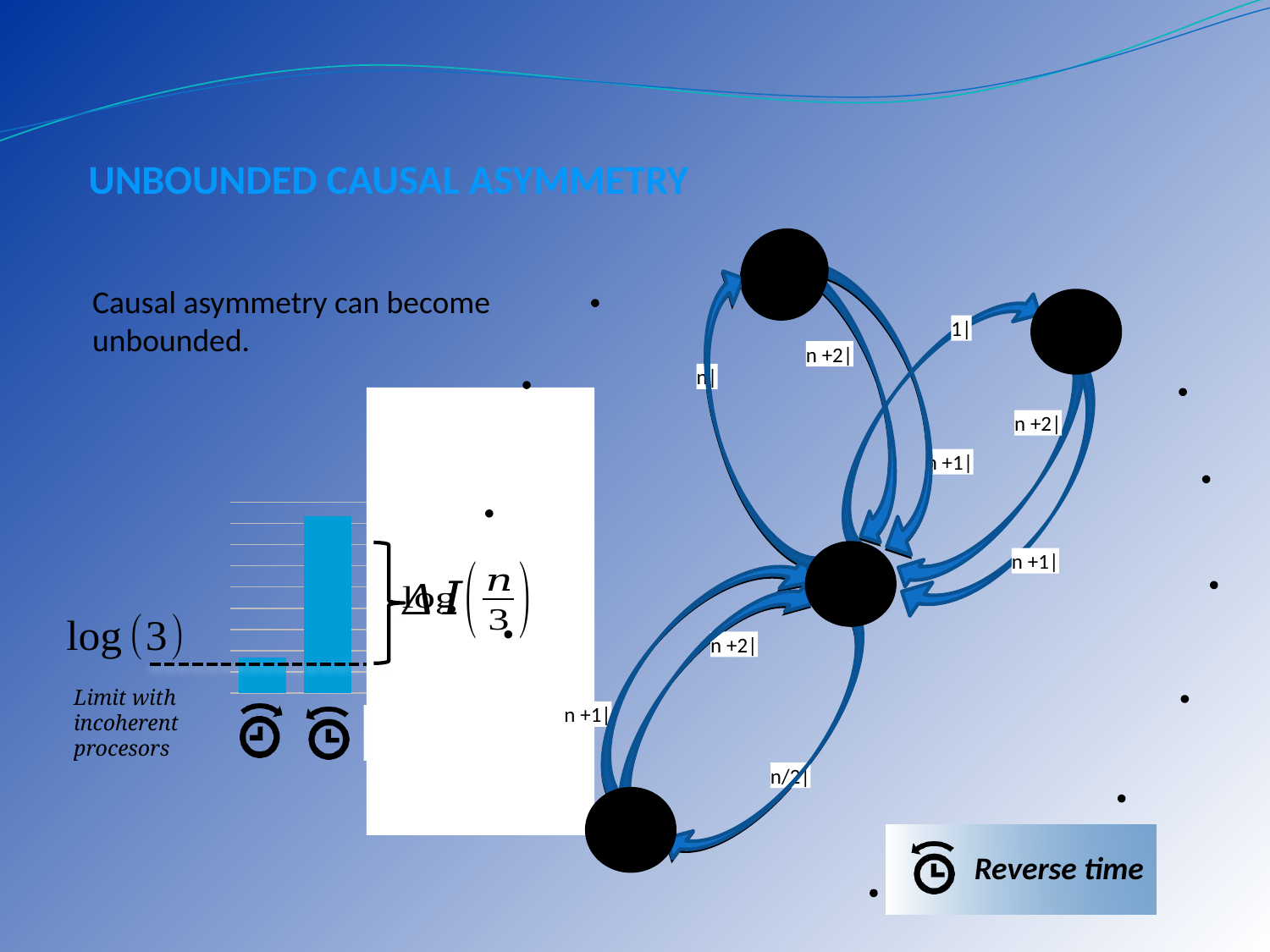
In the bar chart on the left of the slide, which bar is the shortest, the left bar or the right bar? the left bar How many bars does the bar chart on the left of the slide show? 2 What kind of chart is shown on the left of the slide? bar chart In the bar chart on the left of the slide, which bar is taller, the left bar or the right bar? the right bar What label is written next to the dashed horizontal line on the bar chart on the left of the slide? log(3) What colour are the bars in the bar chart on the left of the slide? blue